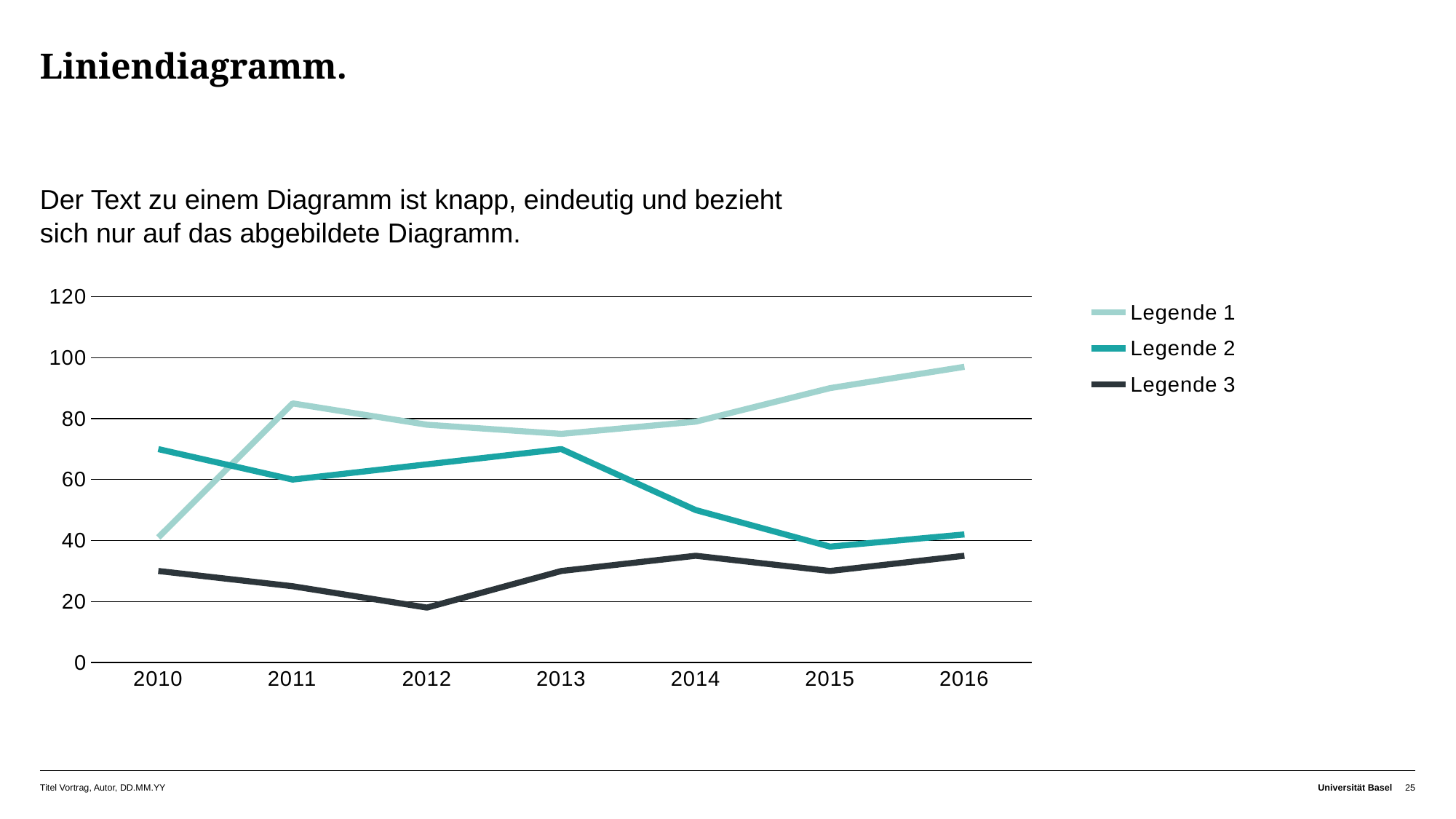
What kind of chart is shown on the slide? line chart In which year does Legende 2 have its lowest value? 2015 Does Legende 1 rise or fall from 2013 to 2016? rise In which year does Legende 1 reach its highest value? 2016 Which series has the higher value in 2010, Legende 1 or Legende 2? Legende 2 Is the value for Legende 1 in 2016 greater or less than 80? greater How many series does the legend list? 3 How many years are shown on the x axis? 7 In which year does Legende 1 have its lowest value? 2010 In which year does Legende 3 have its lowest value? 2012 What is the title of the slide? Liniendiagramm.